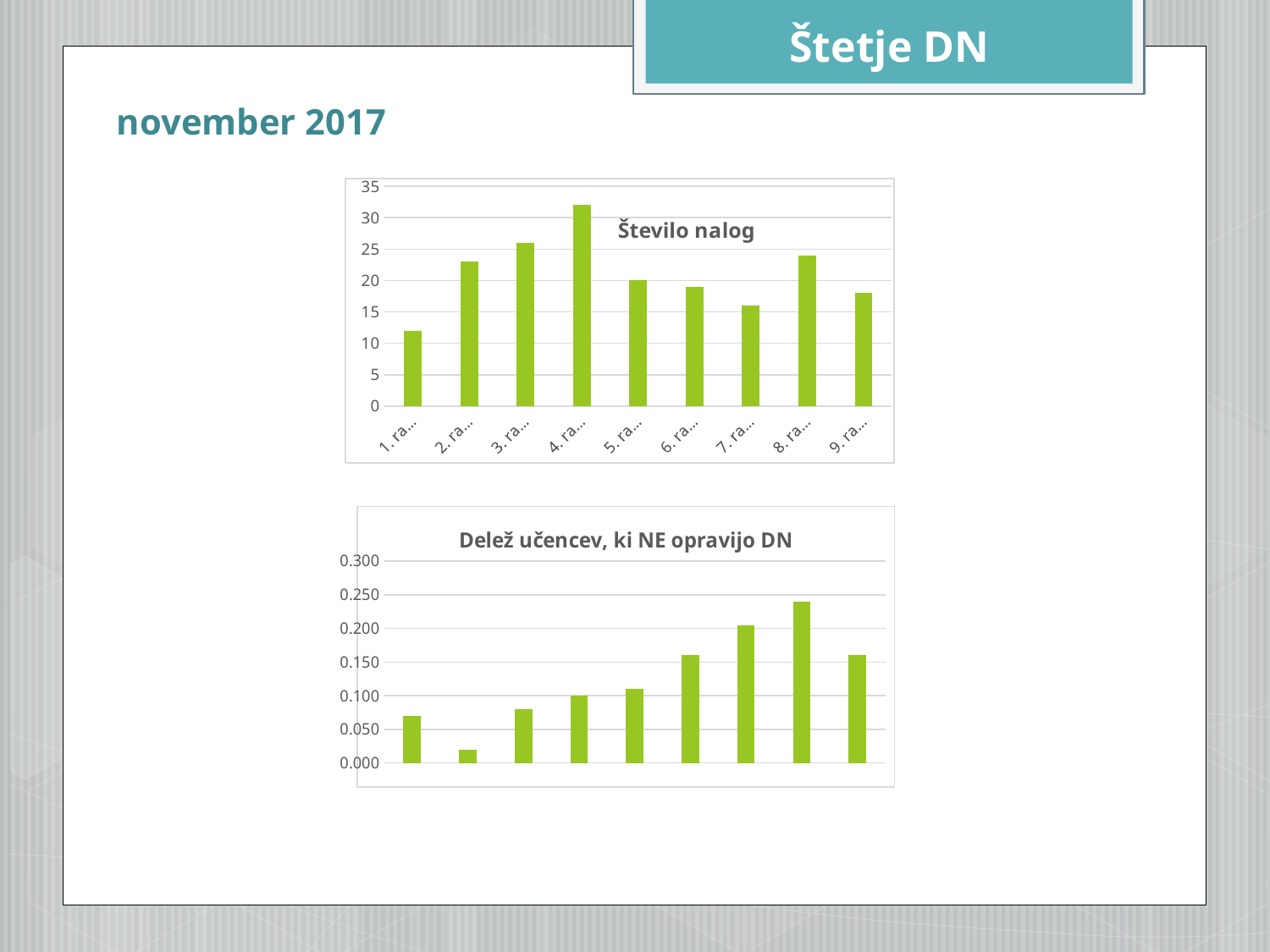
In the top chart "Število nalog", is the value for 1. ra… greater or less than 15? less In the bottom chart "Delež učencev, ki NE opravijo DN", which category has the lowest value? 2. ra… In the bottom chart "Delež učencev, ki NE opravijo DN", is the value for 8. ra… greater or less than 0.200? greater In the top chart "Število nalog", is the value for 4. ra… greater or less than 30? greater In the top chart "Število nalog", which category has the lowest value? 1. ra… In the top chart "Število nalog", which has the larger value, 1. ra… or 2. ra…? 2. ra… What kind of chart is the bottom chart titled "Delež učencev, ki NE opravijo DN"? bar chart In the bottom chart "Delež učencev, ki NE opravijo DN", which category has the highest value? 8. ra… What is the title of the bottom chart on the slide? Delež učencev, ki NE opravijo DN In the top chart "Število nalog", how many categories are shown on the x axis? 9 What kind of chart is the top chart titled "Število nalog"? bar chart In the top chart "Število nalog", which category has the highest value? 4. ra…